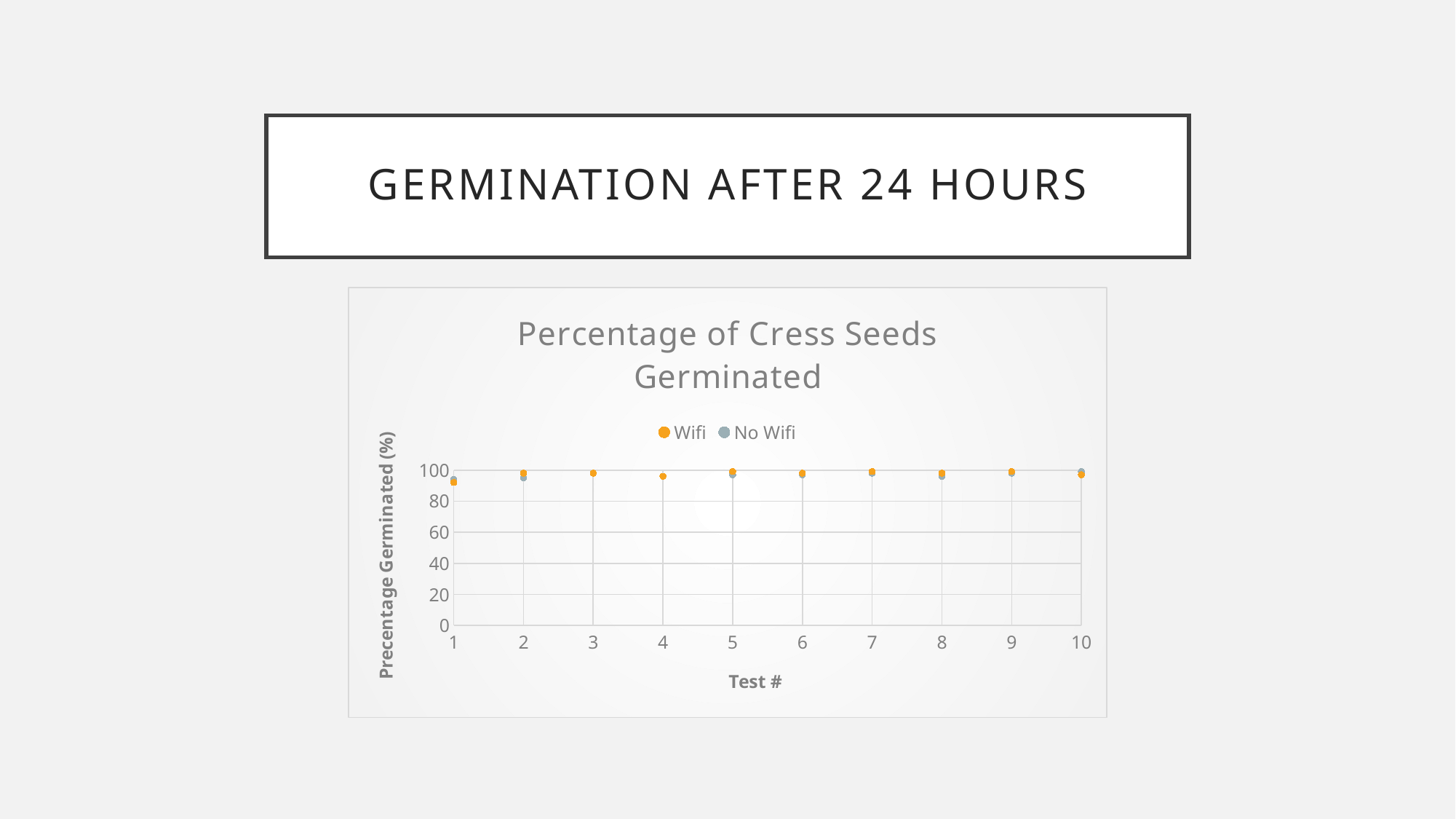
Is the Wifi value for Test 1 greater or less than 80? greater Is the Wifi value for Test 4 greater or less than 80? greater Is the No Wifi value for Test 5 greater or less than 20? greater What is the title of the chart? Percentage of Cress Seeds Germinated What are the two series named in the legend? Wifi and No Wifi What kind of chart is shown on the slide? scatter chart How many series does the legend list? 2 How many tests are plotted along the x axis? 10